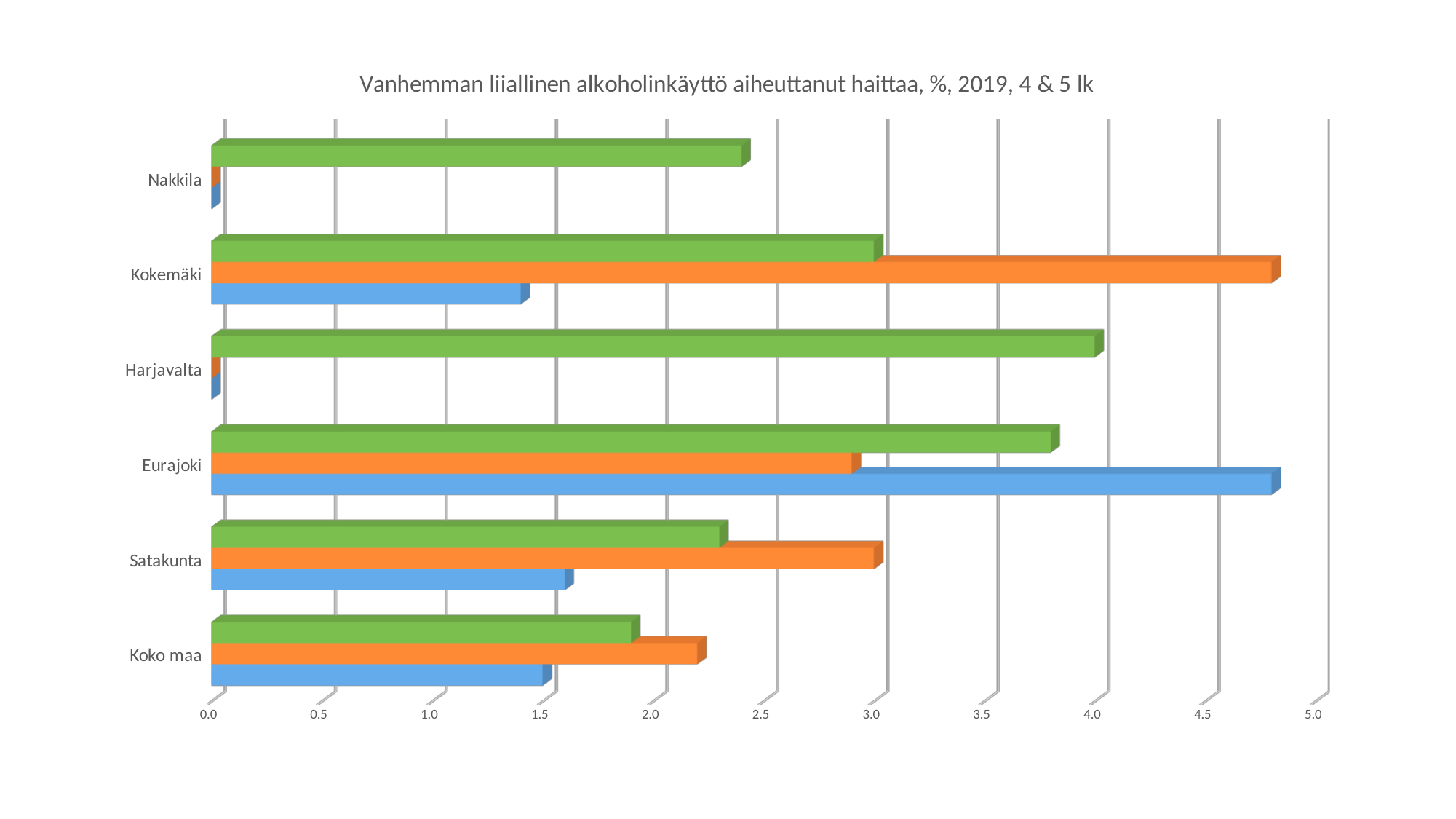
How many bars are shown for Eurajoki? 3 Is the blue bar for Eurajoki greater or less than 4.0? greater Which category has the longest blue bar? Eurajoki How many categories (areas) are listed on the vertical axis of the chart? 6 Which category has the longest orange bar? Kokemäki Is the blue bar for Koko maa greater or less than 2.0? less What is the title of the chart? Vanhemman liiallinen alkoholinkäyttö aiheuttanut haittaa, %, 2019, 4 & 5 lk Is the green bar for Harjavalta greater or less than 3.0? greater Which is longer, the blue bar for Eurajoki or the blue bar for Kokemäki? Eurajoki What type of chart is shown on the slide? bar chart Which is longer, the green bar for Harjavalta or the green bar for Nakkila? Harjavalta